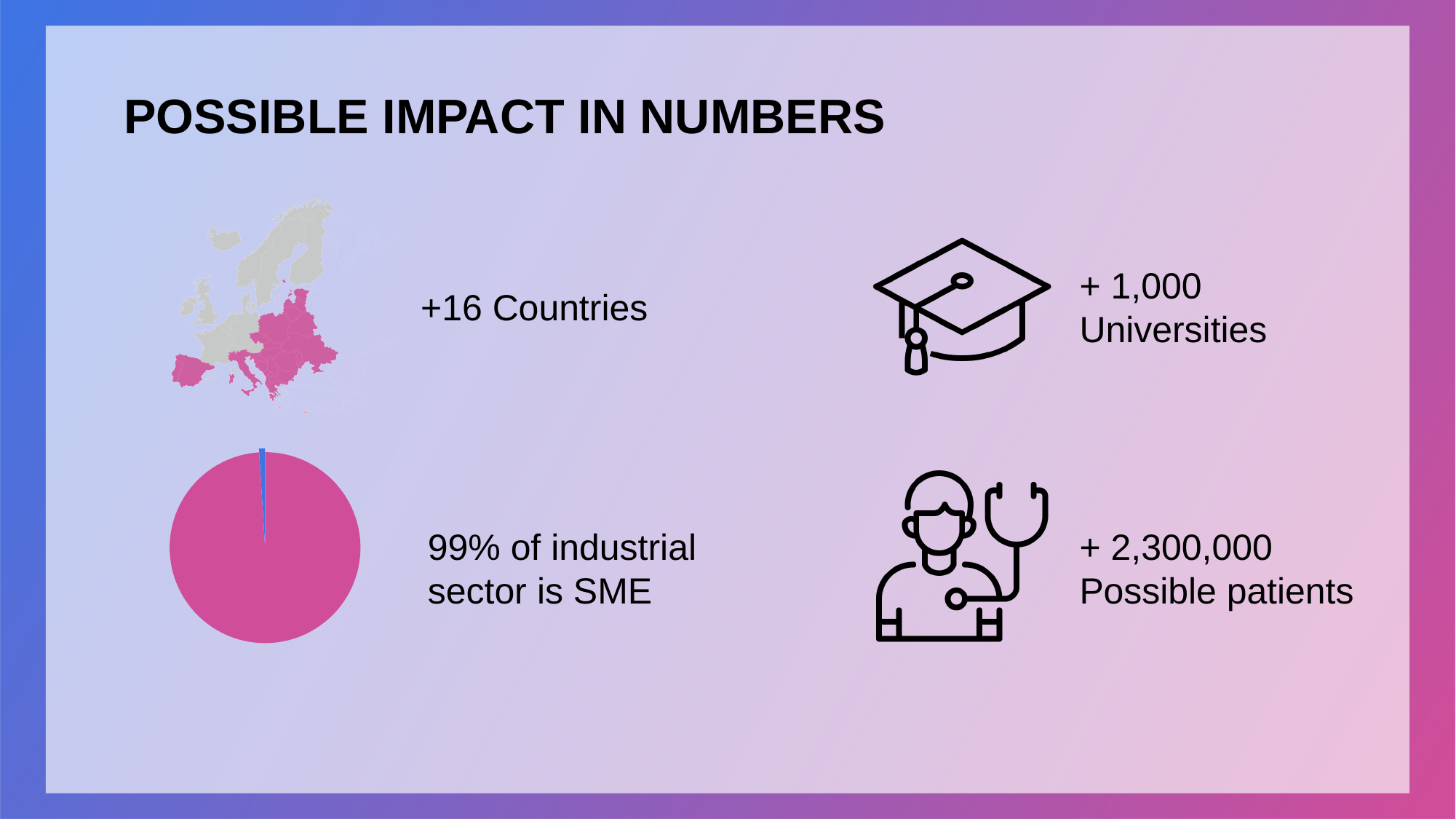
According to the text beside the pie chart, what share of the industrial sector is SME? 99% Does the pie chart on the slide show a legend? No What colour is the largest slice of the pie chart? pink How many slices does the pie chart on the slide have? 2 What kind of chart is shown on the slide next to the text "99% of industrial sector is SME"? pie chart Which slice of the pie chart is larger, the pink one or the blue one? the pink one